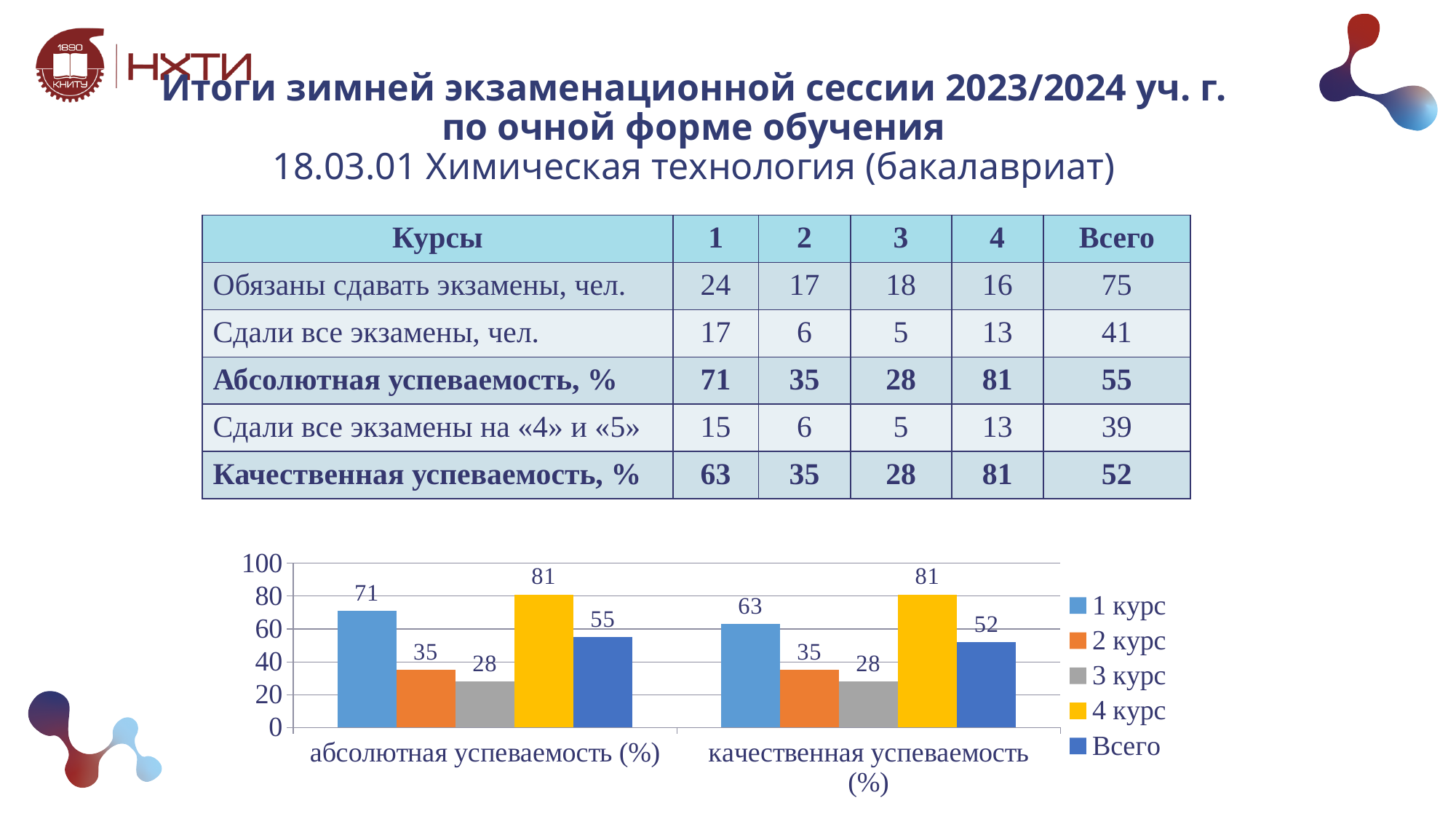
Which series has the lowest value in the качественная успеваемость (%) category? 3 курс What type of chart is shown on the slide? bar chart Which is larger: the 2 курс value or the 3 курс value in the абсолютная успеваемость (%) category? 2 курс What is the value for Всего in the качественная успеваемость (%) category? 52 Which series has the highest value in the абсолютная успеваемость (%) category? 4 курс What is the value for 1 курс in the абсолютная успеваемость (%) category? 71 What colour are the bars for 4 курс in the chart? yellow How many series does the chart legend list? 5 Is the value for Всего in the абсолютная успеваемость (%) category greater or less than 40? greater How many categories are shown on the x axis of the chart? 2 What is the value for 3 курс in the качественная успеваемость (%) category? 28 What is the difference between the 1 курс values for абсолютная успеваемость (%) and качественная успеваемость (%)? 8